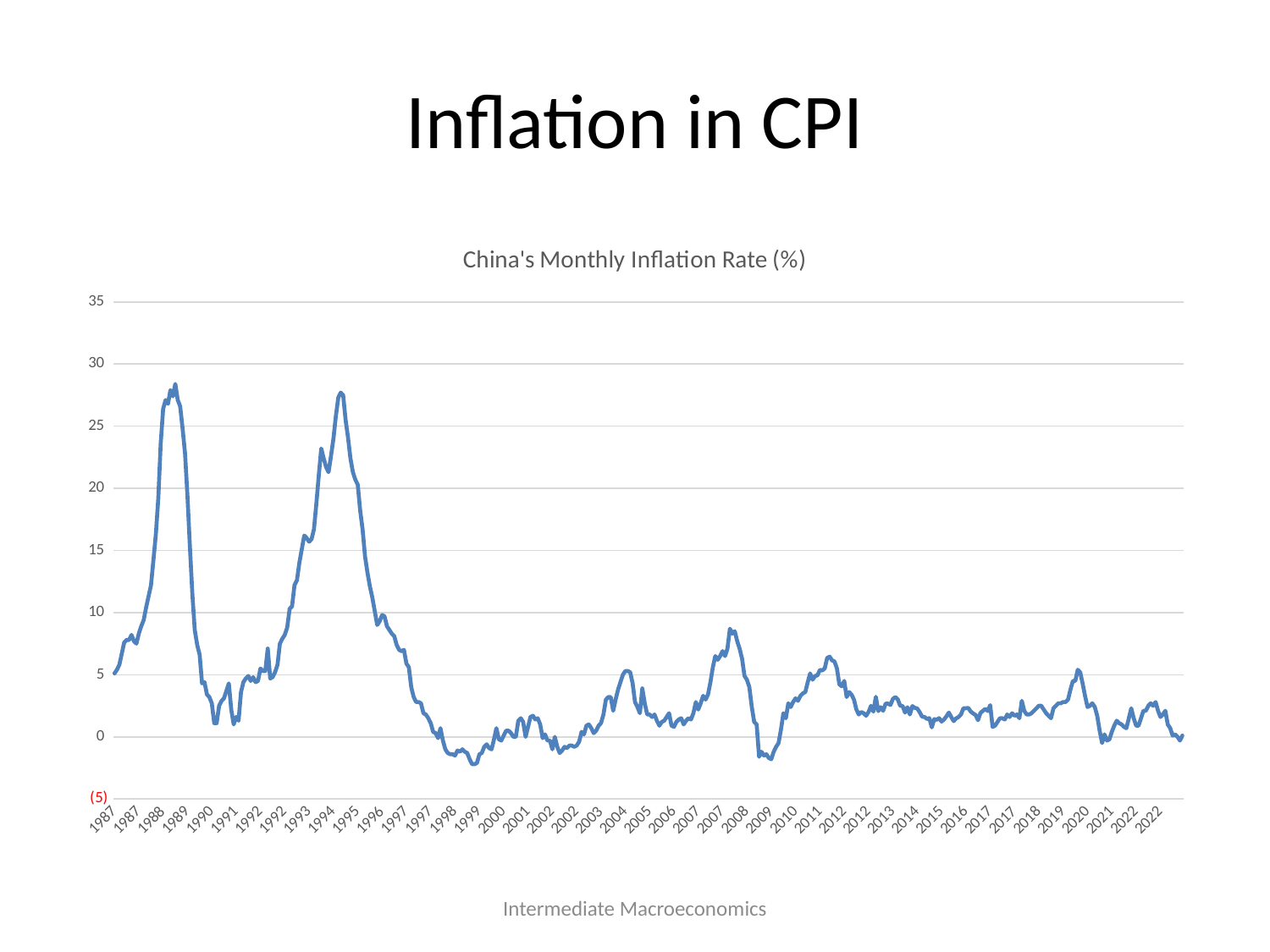
Is the lowest inflation rate around 2009 greater or less than 0? less What kind of chart is shown on the slide? line chart Is the inflation rate at the end of 2022 greater or less than 5? less Does the inflation rate rise or fall between 1987 and 1988? rise Is the peak inflation rate around 2008 greater or less than 5? greater Does the inflation rate rise or fall between 1995 and 1998? fall What is the title of the chart? China's Monthly Inflation Rate (%) What is the highest value shown on the vertical axis of the chart? 35